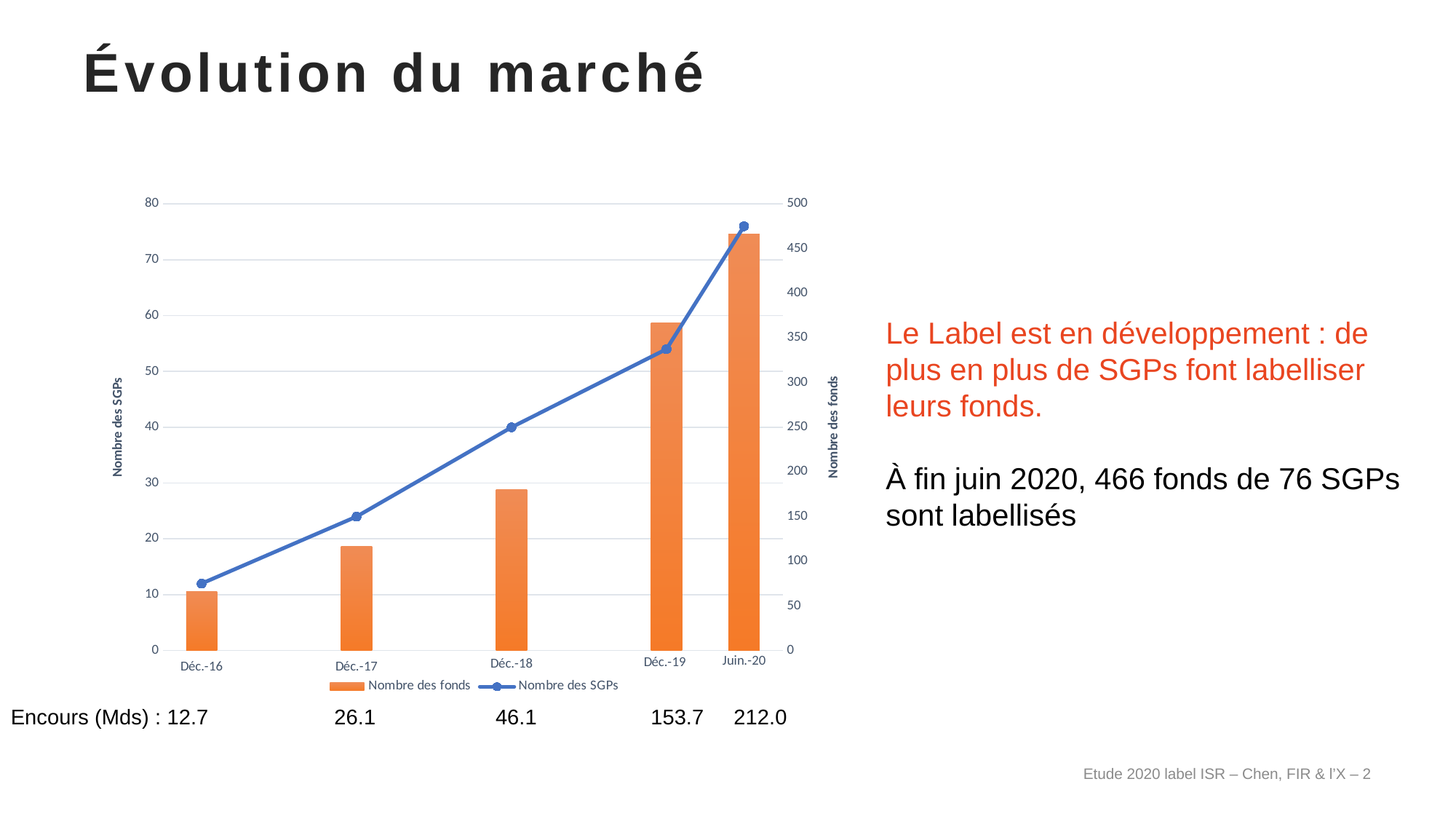
Is the Nombre des SGPs value for Déc.-17 greater or less than 30? less In which period is the Nombre des fonds bar the highest? Juin.-20 Is the Nombre des fonds value for Déc.-19 greater or less than 300? greater What kind of chart is shown on the slide? A bar chart combined with a line chart Do the Nombre des SGPs values rise or fall from Déc.-16 to Juin.-20? Rise How many time periods are shown on the x axis of the chart? 5 Which series are listed in the chart legend? Nombre des fonds and Nombre des SGPs Which period has the larger Nombre des SGPs value, Déc.-17 or Déc.-19? Déc.-19 In which period is the Nombre des fonds bar the lowest? Déc.-16 What is the title of the left vertical axis? Nombre des SGPs How many series does the chart legend list? 2 Is the Nombre des SGPs value for Juin.-20 greater or less than 70? greater